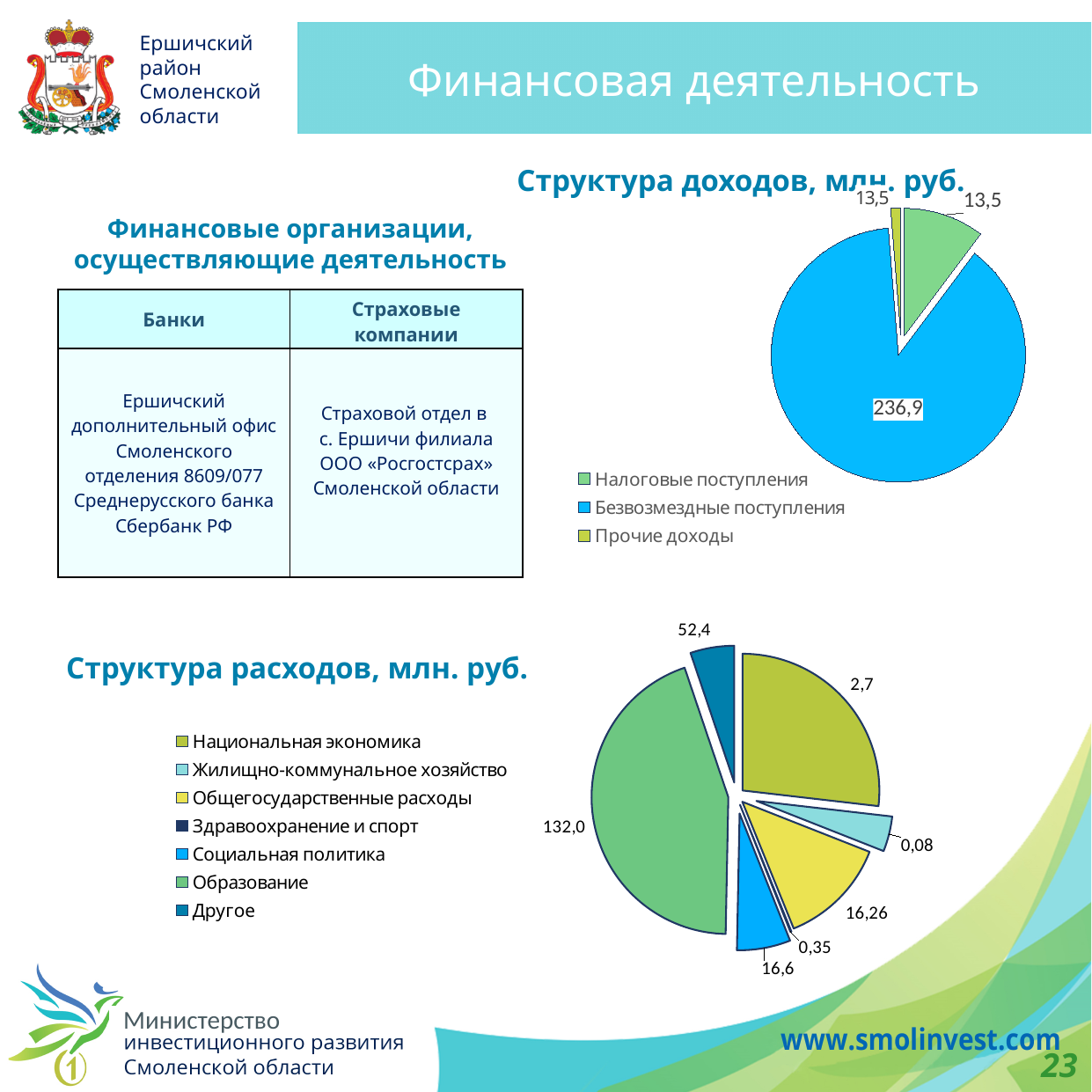
In the chart 'Структура доходов, млн. руб.', what is the value for Безвозмездные поступления? 236,9 How many categories does the legend of the chart 'Структура расходов, млн. руб.' list? 7 In the chart 'Структура доходов, млн. руб.', which category has the largest share? Безвозмездные поступления What kind of chart is 'Структура доходов, млн. руб.'? Pie chart In the chart 'Структура расходов, млн. руб.', what is the value for Общегосударственные расходы? 16,26 In the chart 'Структура расходов, млн. руб.', what colour is the slice for Образование? Green In the chart 'Структура расходов, млн. руб.', what is the value for Социальная политика? 16,6 In the chart 'Структура расходов, млн. руб.', what is the difference between Социальная политика and Общегосударственные расходы? 0,34 In the chart 'Структура расходов, млн. руб.', what is the value for Образование? 132,0 In the chart 'Структура расходов, млн. руб.', which is larger: Образование or Общегосударственные расходы? Образование In the chart 'Структура расходов, млн. руб.', which category has the largest share? Образование How many entries does the legend of the chart 'Структура доходов, млн. руб.' list? 3